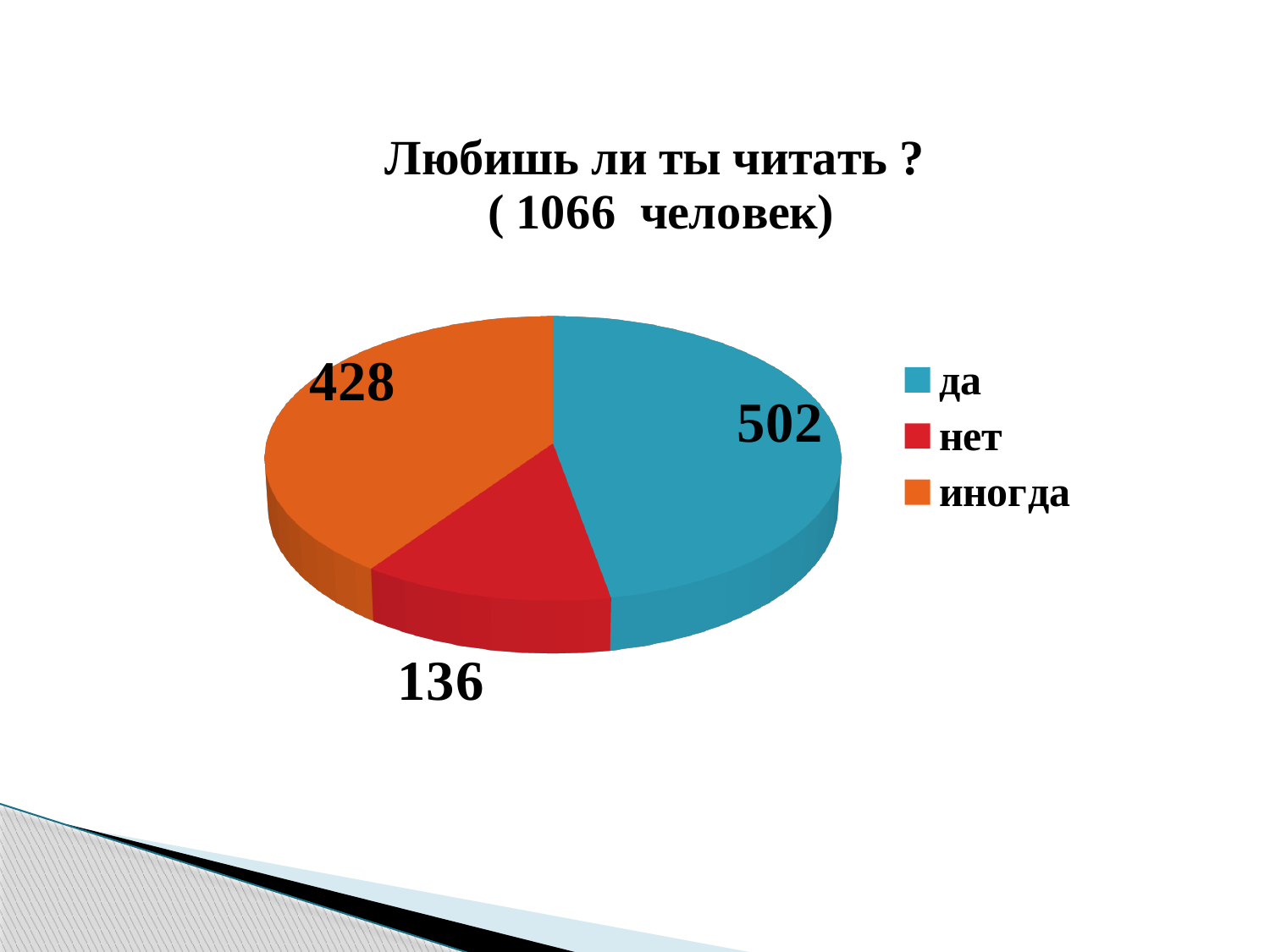
What is the value for "да"? 502 How many slices does the pie chart have? 3 How many entries does the legend list? 3 What is the value for "иногда"? 428 What is the title of the chart? Любишь ли ты читать ? ( 1066 человек) Which is larger, the value for "иногда" or the value for "нет"? иногда What is the value for "нет"? 136 What kind of chart is shown on the slide? pie chart What is the difference between the values for "да" and "иногда"? 74 What colour is the slice for "нет"? red Which category has the smallest slice? нет Which category has the largest slice? да